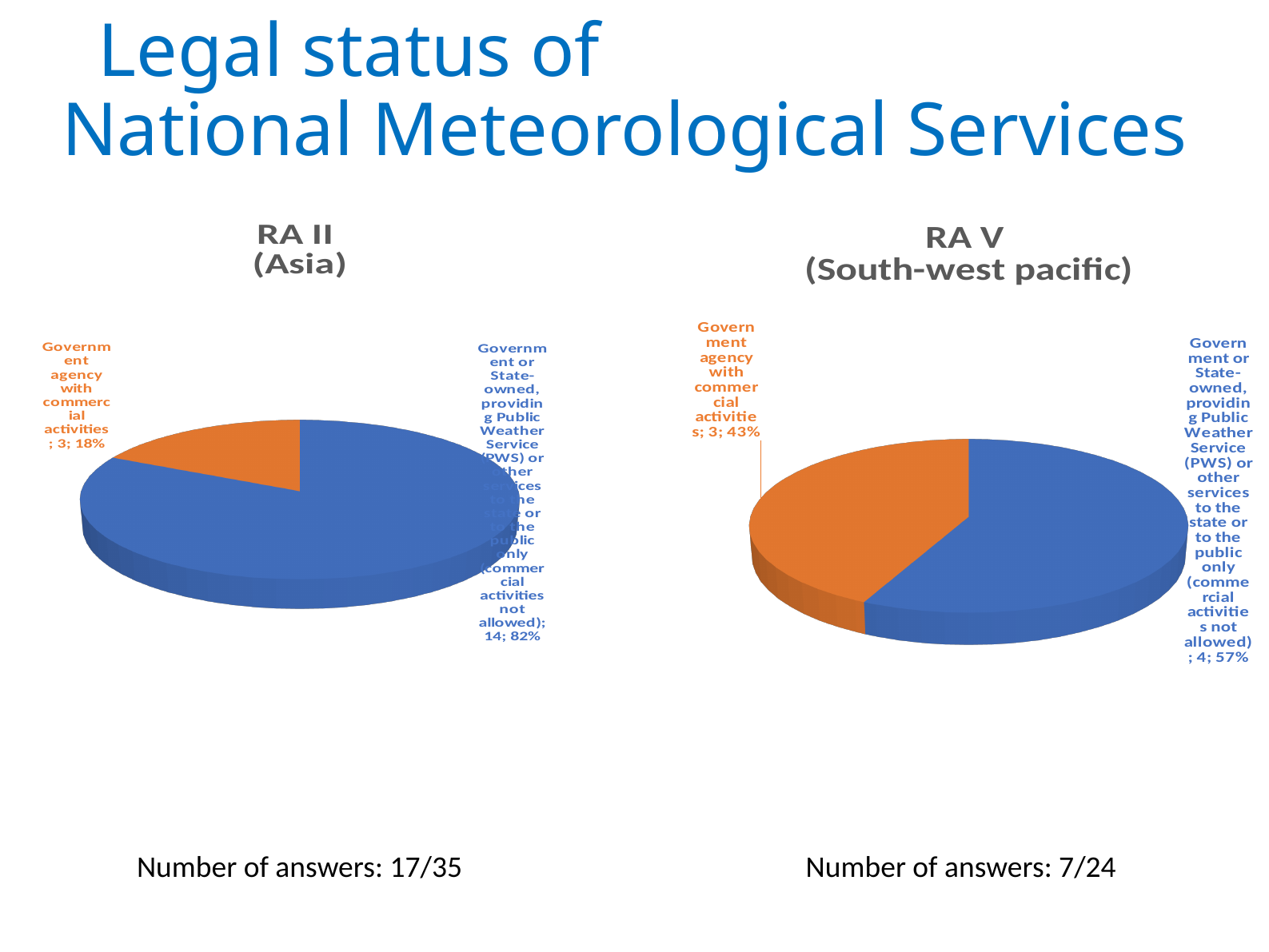
In the RA II (Asia) chart, how many slices does the pie have? 2 In the RA V (South-west pacific) chart, which category has the smallest slice? Government agency with commercial activities In the RA II (Asia) chart, what percentage share does 'Government agency with commercial activities' have? 18% In the RA V (South-west pacific) chart, what percentage share does the 'Government or State-owned' (commercial activities not allowed) slice have? 57% In the RA II (Asia) chart, what is the count for 'Government agency with commercial activities'? 3 In the RA II (Asia) chart, what colour is the 'Government agency with commercial activities' slice? orange In the RA V (South-west pacific) chart, what is the difference in count between the 'Government or State-owned' slice and the 'Government agency with commercial activities' slice? 1 In the RA II (Asia) chart, what percentage share does the 'Government or State-owned' (commercial activities not allowed) slice have? 82% In the RA II (Asia) chart, which category has the largest slice? Government or State-owned, providing Public Weather Service (PWS) or other services to the state or to the public only (commercial activities not allowed) In the RA II (Asia) chart, what is the count for 'Government or State-owned, providing Public Weather Service (PWS) or other services to the state or to the public only (commercial activities not allowed)'? 14 In the RA II (Asia) chart, what kind of chart is shown? pie chart In the RA V (South-west pacific) chart, what is the count for 'Government agency with commercial activities'? 3